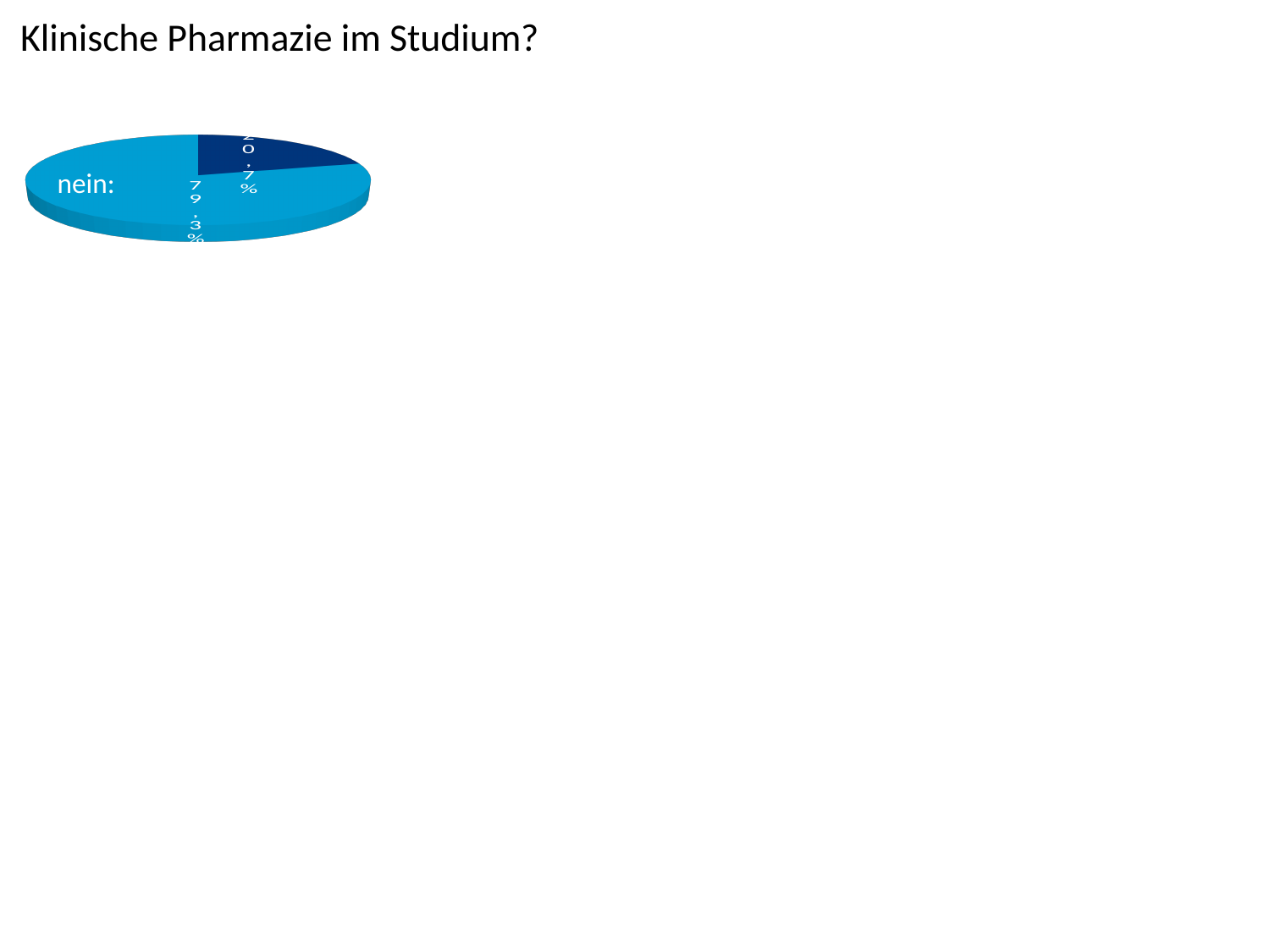
What colour is the "nein" slice of the pie chart? light blue Which slice of the pie chart is the largest? nein What is the title text shown above the pie chart? Klinische Pharmazie im Studium? What percentage is shown for the "nein" slice of the pie chart? 79,3% How many slices does the pie chart have? 2 Is the "nein" slice larger or smaller than the dark blue slice? larger Which slice of the pie chart is the smallest? the dark blue slice What kind of chart is shown on the slide? pie chart